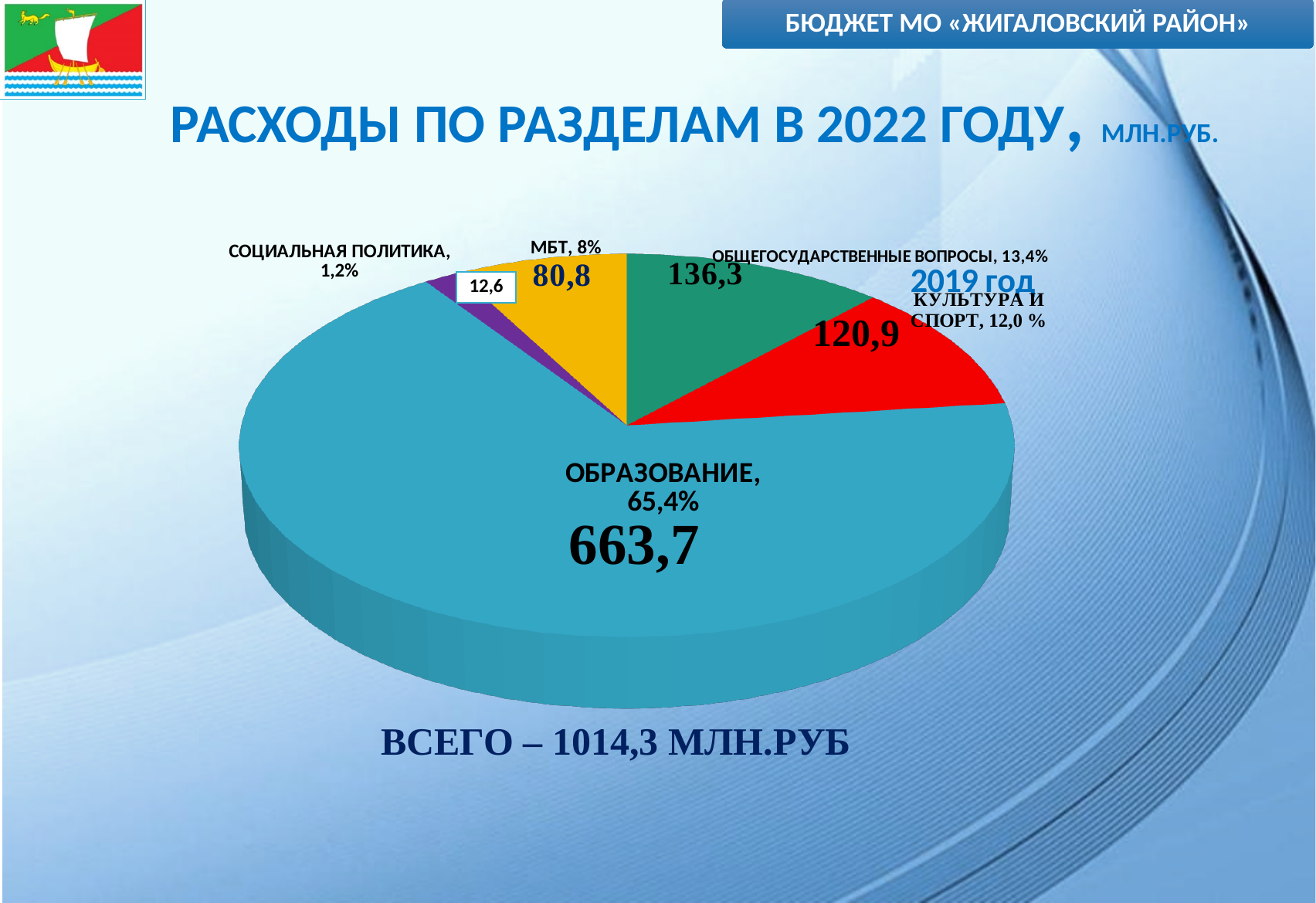
What is the value for СОЦИАЛЬНАЯ ПОЛИТИКА in the pie chart? 12,6 Which section of the pie chart is the smallest? СОЦИАЛЬНАЯ ПОЛИТИКА Which section of the pie chart is the largest? ОБРАЗОВАНИЕ What share of the pie does КУЛЬТУРА И СПОРТ account for? 12,0 % What kind of chart is shown on the slide? pie chart What share of the pie does ОБРАЗОВАНИЕ account for? 65,4% What is the value for МБТ in the pie chart? 80,8 What is the value for ОБЩЕГОСУДАРСТВЕННЫЕ ВОПРОСЫ in the pie chart? 136,3 How many sections (slices) does the pie chart have? 5 What is the value for ОБРАЗОВАНИЕ in the pie chart? 663,7 What is the value for КУЛЬТУРА И СПОРТ in the pie chart? 120,9 What is the difference between the values for ОБЩЕГОСУДАРСТВЕННЫЕ ВОПРОСЫ and КУЛЬТУРА И СПОРТ? 15,4